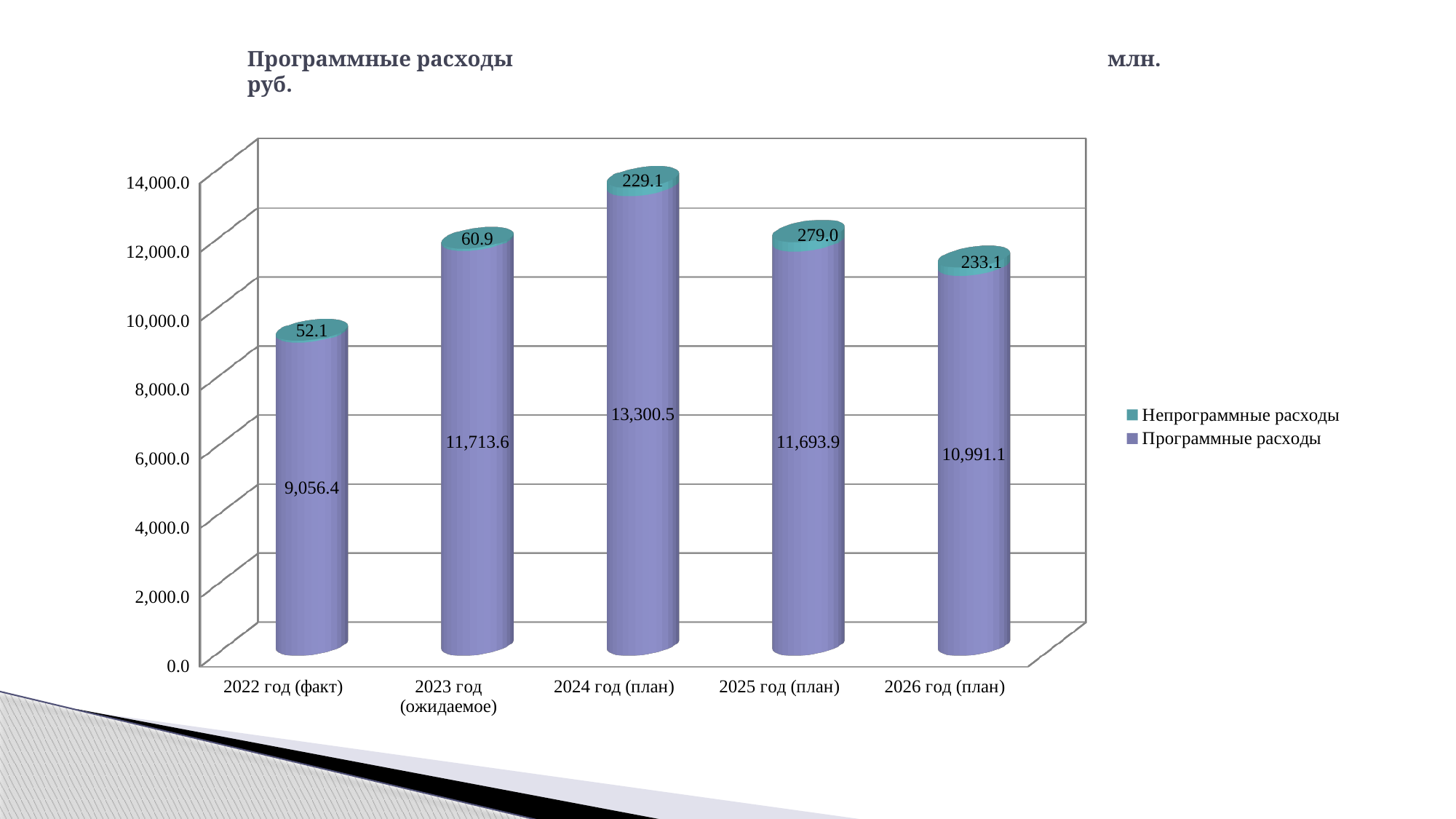
Which year has the highest value of Программные расходы? 2024 год (план) What is the value of Программные расходы for 2026 год (план)? 10,991.1 How many year categories are shown on the x axis? 5 Which is larger: Непрограммные расходы in 2025 год (план) or in 2026 год (план)? 2025 год (план) How many series does the legend list? 2 What is the total of the stacked bar for 2025 год (план)? 11,972.9 What kind of chart is shown on the slide? Stacked bar chart What is the value of Непрограммные расходы for 2022 год (факт)? 52.1 Which year has the lowest value of Непрограммные расходы? 2022 год (факт) Is the total bar height for 2022 год (факт) greater or less than 10,000.0? less What is the value of Программные расходы for 2024 год (план)? 13,300.5 What is the difference between Программные расходы in 2024 год (план) and 2023 год (ожидаемое)? 1,586.9